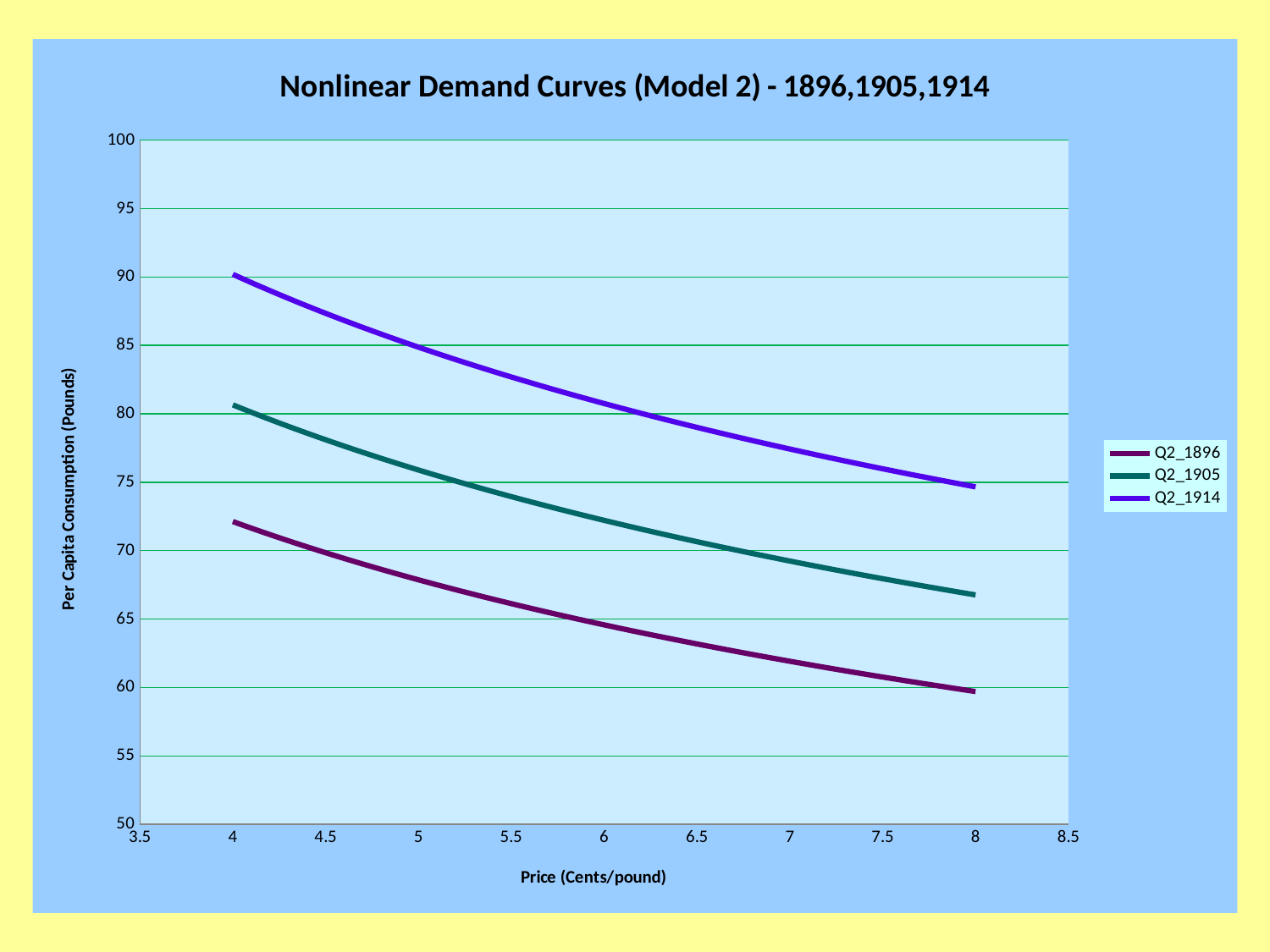
Which series has the lowest per capita consumption across the price range? Q2_1896 How many series does the legend list? 3 At a price of 6 cents/pound, which series has the larger value, Q2_1914 or Q2_1896? Q2_1914 What is the title of the chart? Nonlinear Demand Curves (Model 2) - 1896,1905,1914 What is the label of the x axis? Price (Cents/pound) Which series has the highest per capita consumption across the price range? Q2_1914 Do the values of the Q2_1914 series rise or fall as price increases? Fall What kind of chart is shown on the slide? Line chart Is the value for Q2_1896 at a price of 4 greater or less than 70? greater Is the value for Q2_1896 at a price of 5 greater or less than 70? less Is the value for Q2_1905 at a price of 8 greater or less than 70? less